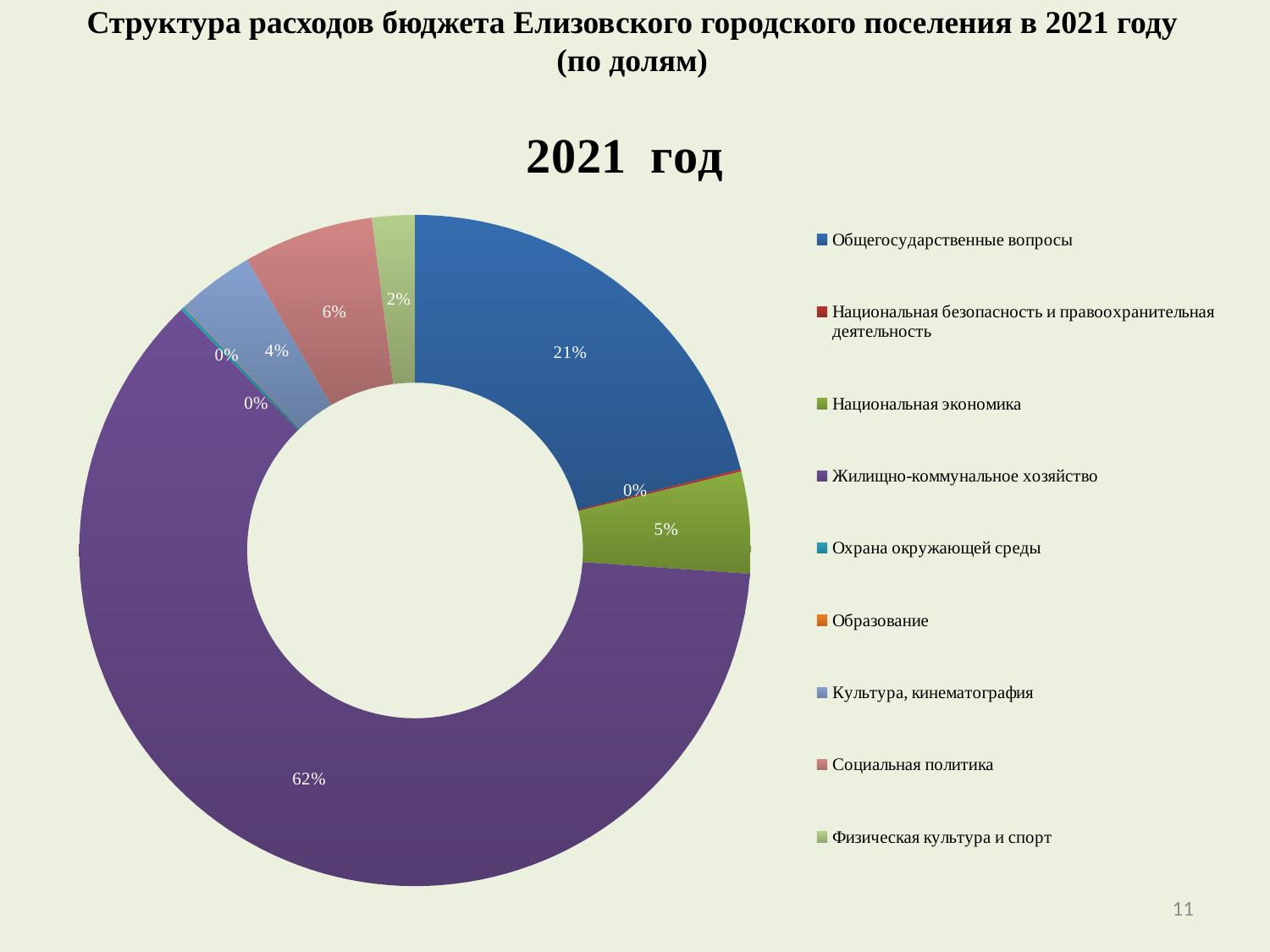
What share of the pie does Жилищно-коммунальное хозяйство have? 62% How many categories does the legend list? 9 What share of the pie does Культура, кинематография have? 4% What is the difference in percentage points between Жилищно-коммунальное хозяйство and Общегосударственные вопросы? 41 What share of the pie does Физическая культура и спорт have? 2% What is the title shown above the chart? 2021 год Which is larger, the share for Социальная политика or the share for Национальная экономика? Социальная политика What kind of chart is shown on the slide? Pie (doughnut) chart Which category has the largest share of the pie? Жилищно-коммунальное хозяйство